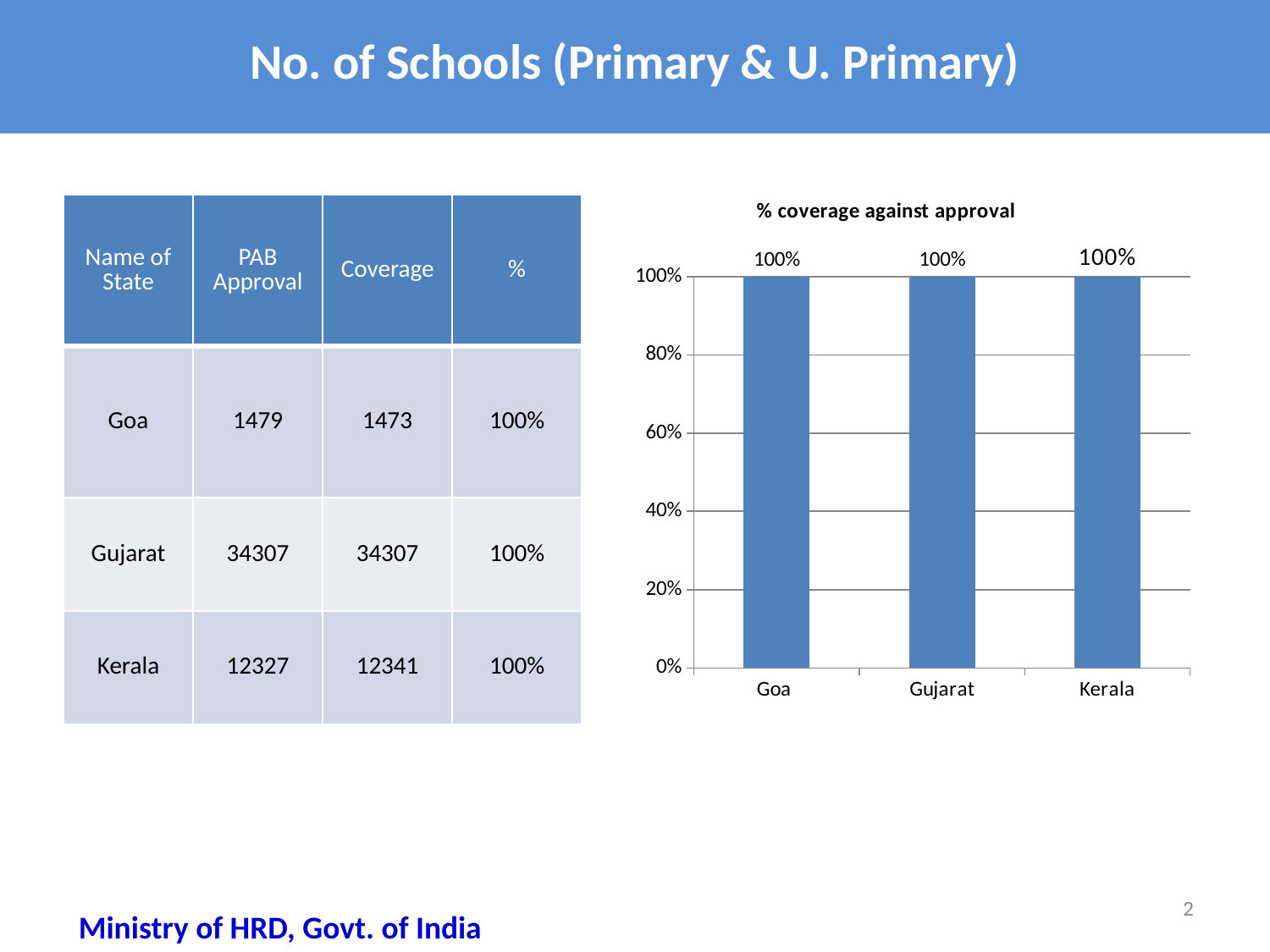
What kind of chart is shown on the slide? bar chart Is the value for Kerala greater or less than 60%? greater What is the difference between the values for Goa and Kerala in the chart? 0% What is the value for Goa in the chart? 100% What is the highest value shown on the chart's y axis? 100% What is the value for Gujarat in the chart? 100% What is the value for Kerala in the chart? 100% How many states are shown on the x axis of the chart? 3 Is the value for Gujarat greater or less than 80%? greater Do the values rise, fall or stay the same from Goa to Kerala along the x axis? stay the same What is the title of the chart? % coverage against approval